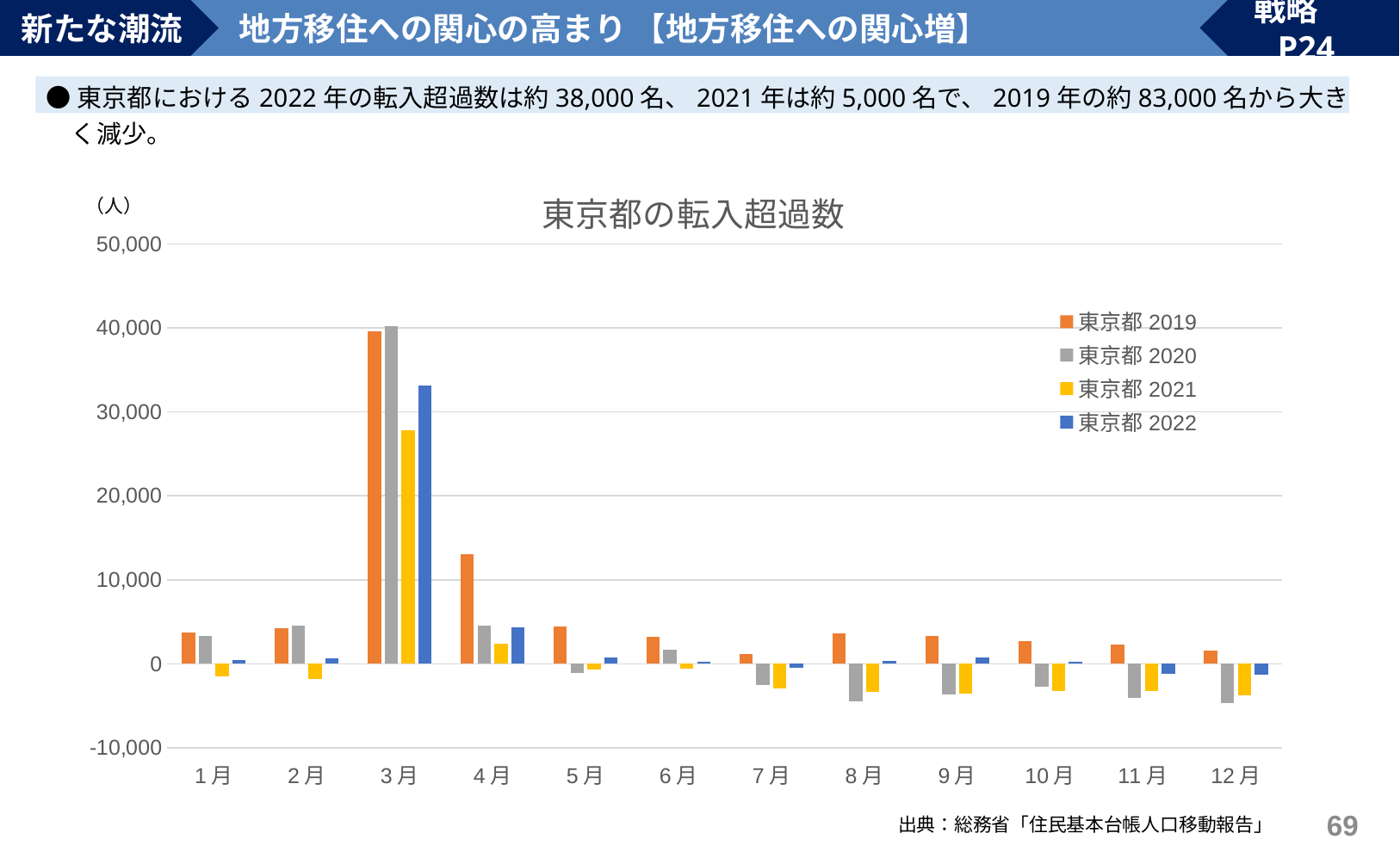
Is the value for 東京都 2019 in 4月 greater or less than 10,000? greater Is the value for 東京都 2019 in 3月 greater or less than 30,000? greater In 1月, which is larger: 東京都 2019 or 東京都 2021? 東京都 2019 Is the value for 東京都 2022 in 3月 greater or less than 30,000? greater How many months are shown along the x axis? 12 How many series does the legend list? 4 In which month is the value for 東京都 2019 highest? 3月 In 4月, which is larger: 東京都 2019 or 東京都 2022? 東京都 2019 What is the title of the chart? 東京都の転入超過数 What kind of chart is shown on the slide? bar chart In 3月, which is larger: 東京都 2020 or 東京都 2021? 東京都 2020